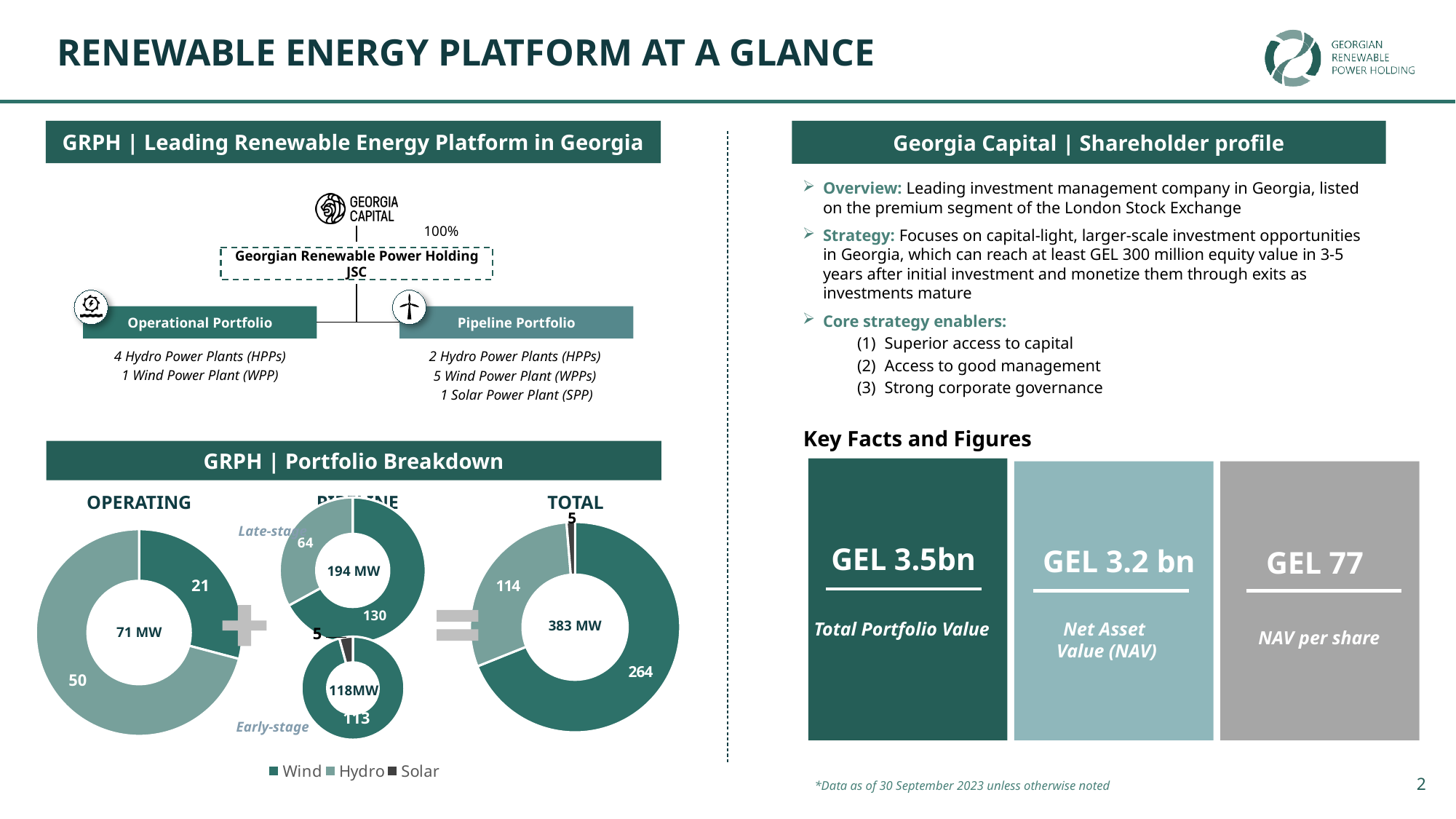
How many series does the legend under the Portfolio Breakdown charts list? 3 In the TOTAL donut chart, what is the difference between the Wind and Hydro values? 150 What total capacity is shown in the centre of the OPERATING donut chart? 71 MW In the OPERATING donut chart, what is the value for Wind? 21 In the Late-stage PIPELINE donut chart, which is larger, Wind or Hydro? Wind In the Early-stage PIPELINE donut chart, what is the value for Solar? 5 In the TOTAL donut chart, what share of the 383 MW total does Hydro (114) represent, to the nearest whole percent? 30% In the OPERATING donut chart, what is the value for Hydro? 50 In the TOTAL donut chart, what is the value for Wind? 264 What kind of chart is used for the OPERATING, PIPELINE and TOTAL portfolio breakdowns? Donut (pie) chart In the TOTAL donut chart, which segment is the smallest? Solar What total capacity is shown in the centre of the Early-stage PIPELINE donut chart? 118MW